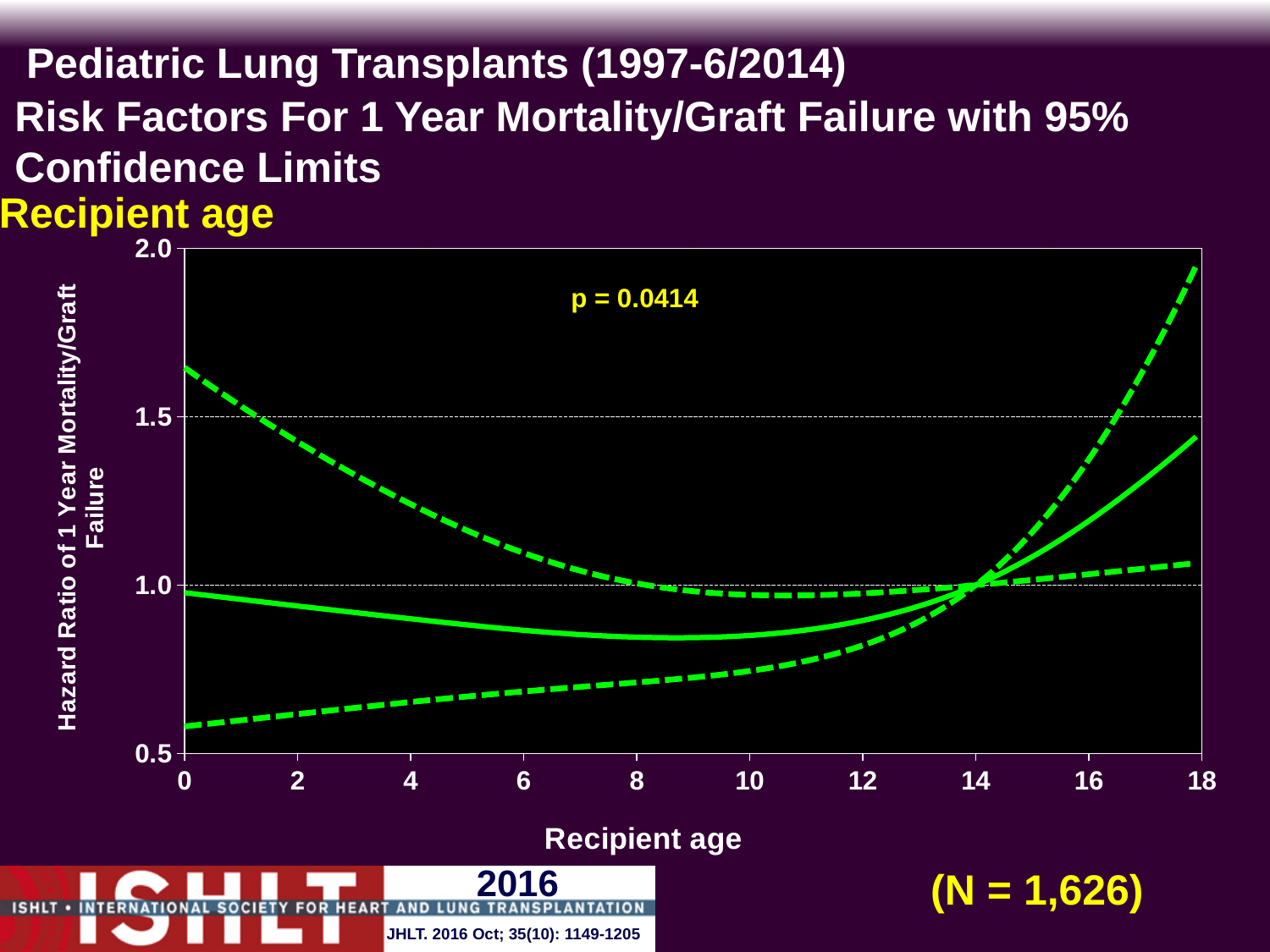
Is the value of the solid hazard ratio line at recipient age 8 greater or less than 1.0? less Is the value of the upper dashed confidence limit at recipient age 18 greater or less than 1.5? greater Does the solid hazard ratio line rise or fall between recipient age 14 and recipient age 18? rise Is the value of the upper dashed confidence limit at recipient age 0 greater or less than 1.5? greater How many lines are plotted on the chart? 3 At which recipient age do the three lines converge at a hazard ratio of 1.0? 14 Does the solid hazard ratio line rise or fall between recipient age 0 and recipient age 8? fall What kind of chart is shown on the slide? line chart What is the sample size (N) shown on the slide? N = 1,626 What is the p-value printed on the chart? p = 0.0414